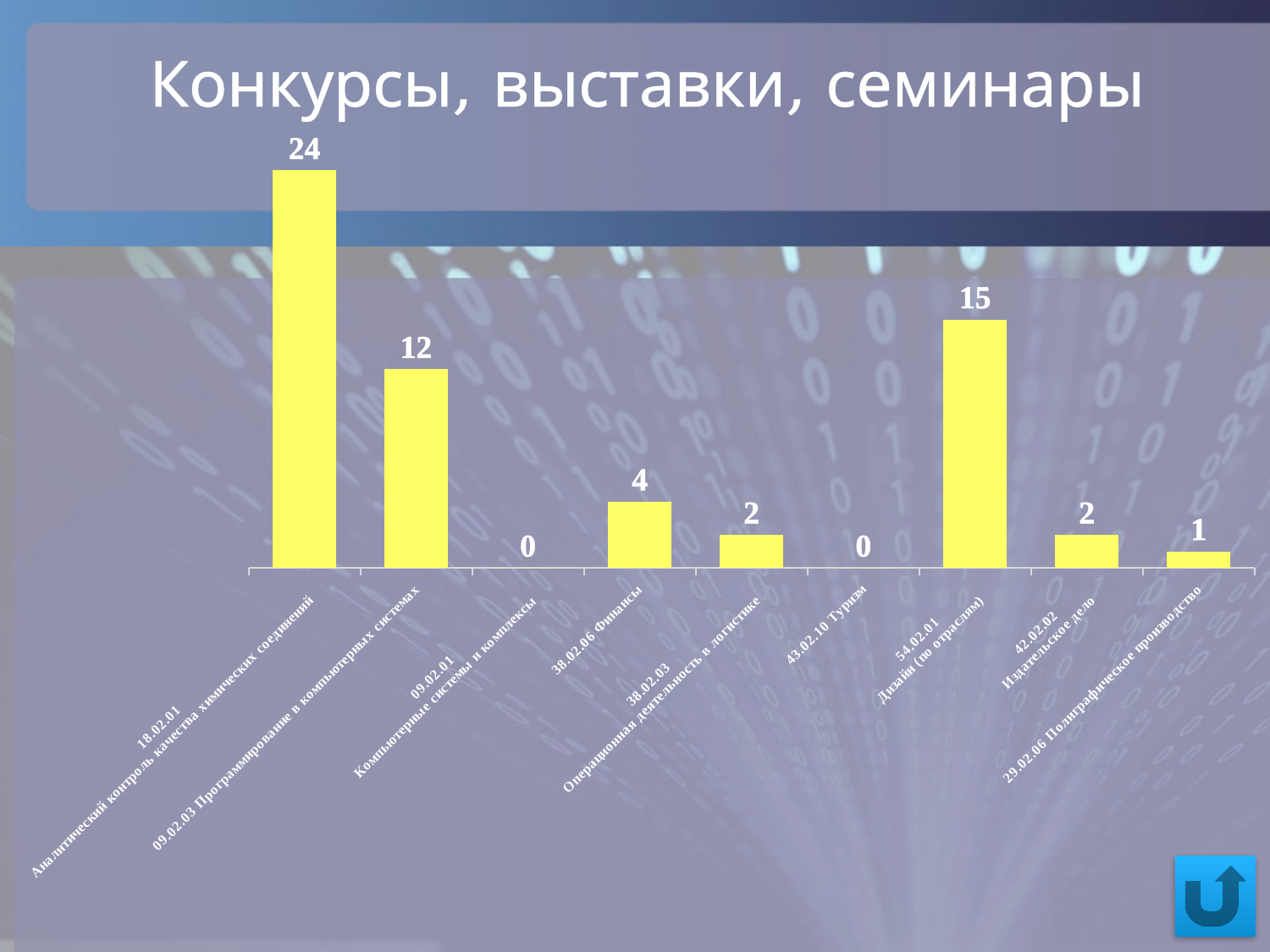
What is the title of the slide? Конкурсы, выставки, семинары What is the value for 09.02.03 Программирование в компьютерных системах? 12 How many categories are shown on the chart? 9 What is the value for 54.02.01 Дизайн (по отраслям)? 15 Which categories have a value of 0? 09.02.01 Компьютерные системы и комплексы and 43.02.10 Туризм Which is larger, the value for 38.02.03 Операционная деятельность в логистике or the value for 38.02.06 Финансы? 38.02.06 Финансы What is the difference between the values for 18.02.01 Аналитический контроль качества химических соединений and 54.02.01 Дизайн (по отраслям)? 9 What is the value for 38.02.06 Финансы? 4 What kind of chart is shown on the slide? Bar chart Which category has the highest value? 18.02.01 Аналитический контроль качества химических соединений What is the value for 29.02.06 Полиграфическое производство? 1 What is the difference between the values for 09.02.03 Программирование в компьютерных системах and 38.02.06 Финансы? 8